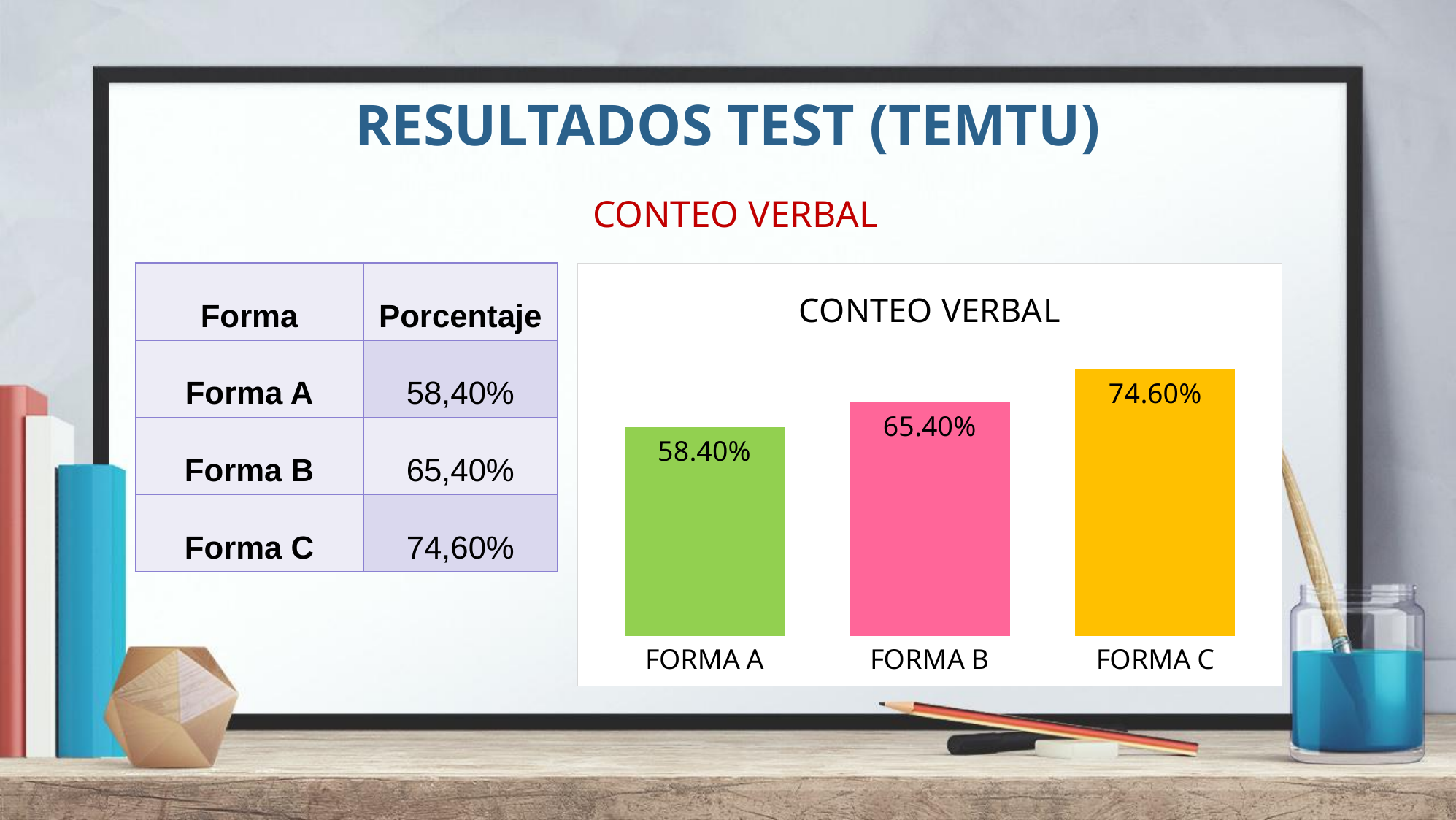
What is the value for FORMA C in the CONTEO VERBAL chart? 74.60% What is the difference between the values for FORMA C and FORMA A in the CONTEO VERBAL chart? 16.20% Which category has the lowest value in the CONTEO VERBAL chart? FORMA A Do the values rise or fall from FORMA A to FORMA C in the CONTEO VERBAL chart? Rise What is the value for FORMA B in the CONTEO VERBAL chart? 65.40% Which category has the highest value in the CONTEO VERBAL chart? FORMA C What is the value for FORMA A in the CONTEO VERBAL chart? 58.40% How many categories are shown in the CONTEO VERBAL chart? 3 What is the title of the chart on the slide? CONTEO VERBAL Which is larger in the CONTEO VERBAL chart, FORMA B or FORMA C? FORMA C What is the difference between the values for FORMA B and FORMA A in the CONTEO VERBAL chart? 7.00% What kind of chart is the CONTEO VERBAL chart? Bar chart